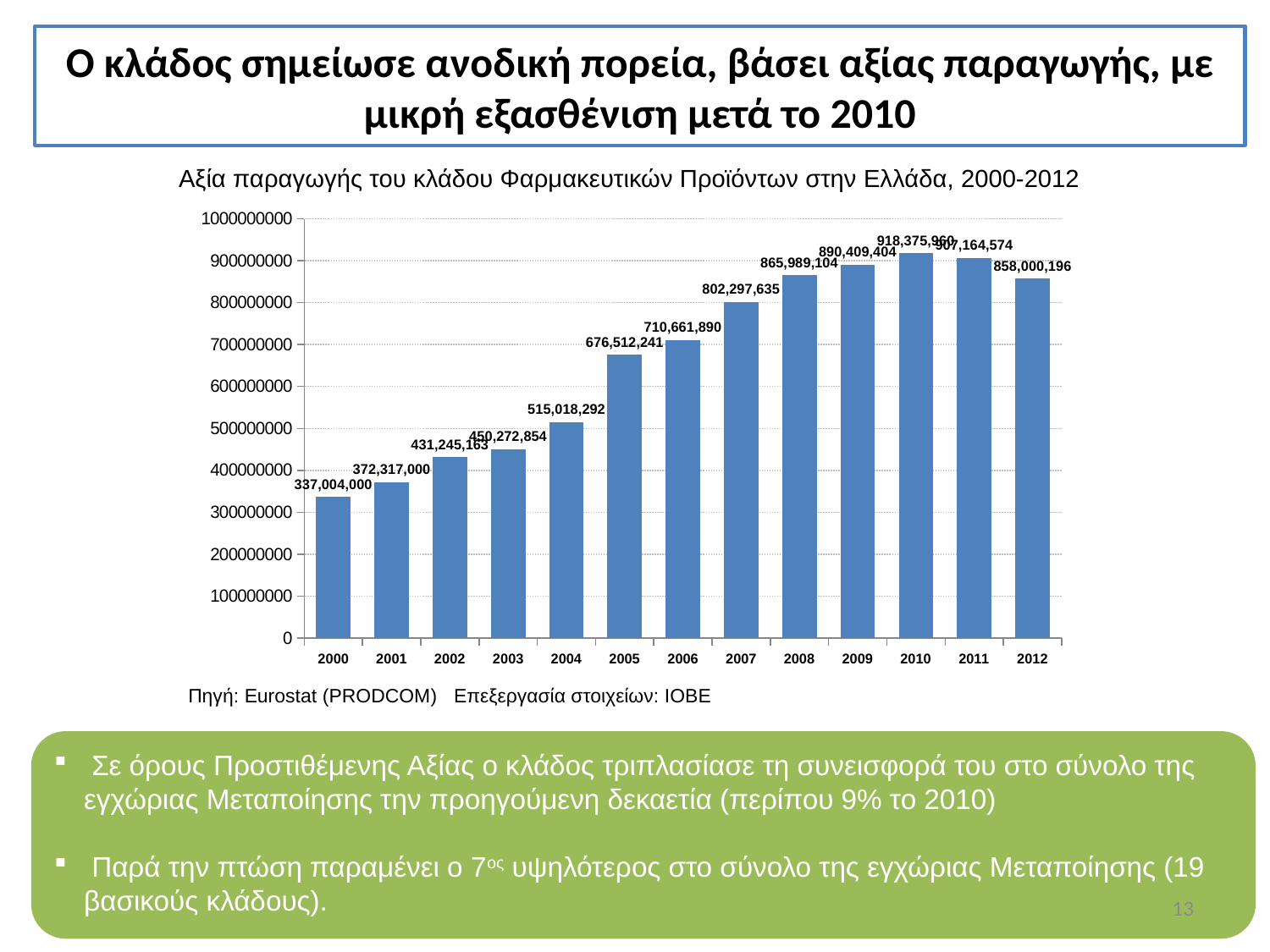
What is the value of production for 2000? 337,004,000 What is the difference between the production values for 2001 and 2000? 35,313,000 What is the value of production for 2007? 802,297,635 Do the production values rise or fall from 2000 to 2010? Rise What is the value of production for 2005? 676,512,241 Is the value for 2004 greater or less than 500000000? greater What kind of chart is shown on the slide? Bar chart What is the value of production for 2012? 858,000,196 Which year has the lowest production value? 2000 Which year has the highest production value? 2010 Which year has the larger production value, 2009 or 2012? 2009 How many years are shown on the x axis of the chart? 13